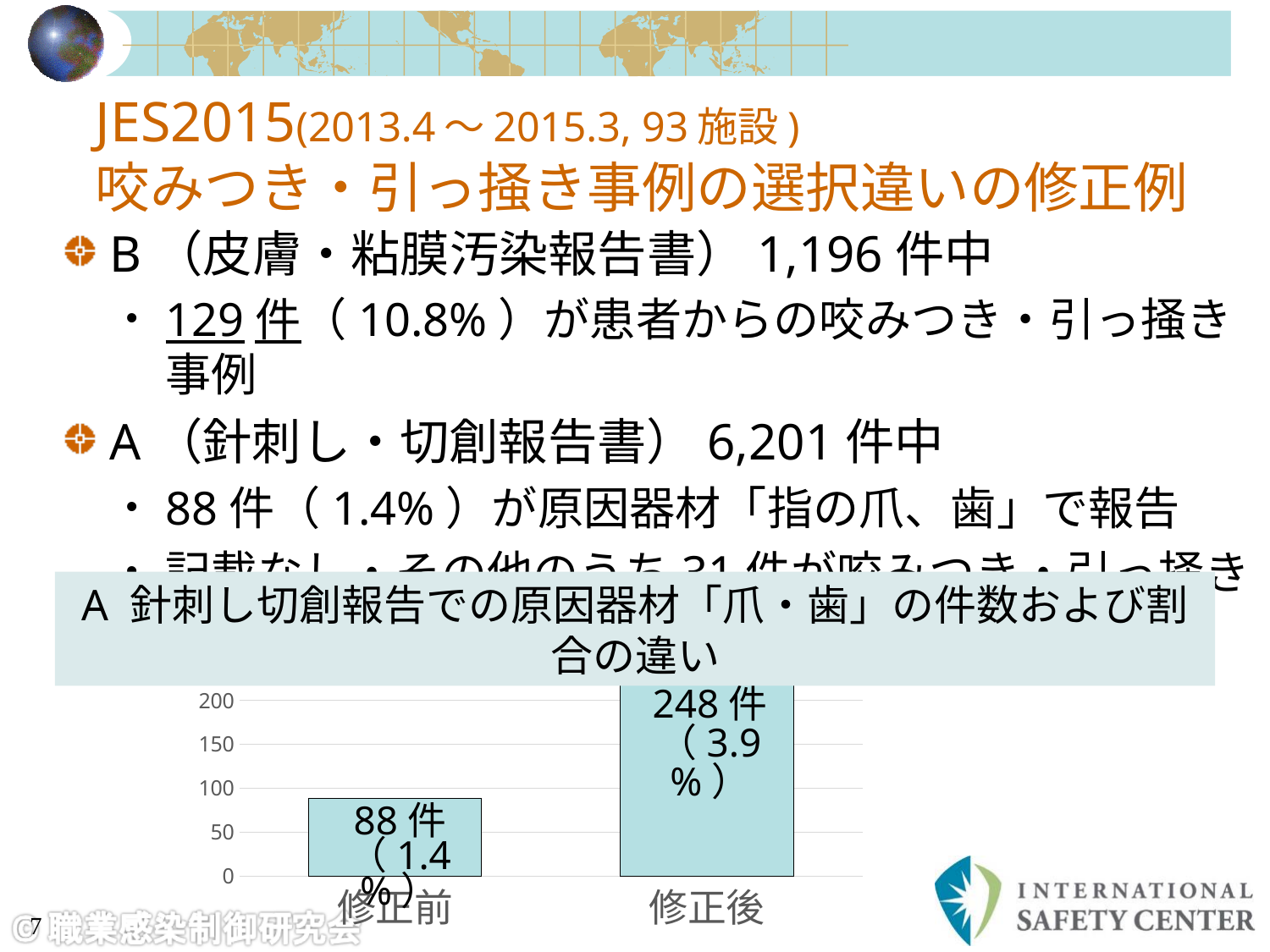
Which category has the lower value in the chart? 修正前 What is the difference in the number of cases between 修正後 and 修正前? 160 件 Which category has the higher value, 修正前 or 修正後? 修正後 What percentage is shown for 修正後 in the chart? 3.9% Is the value for 修正後 greater or less than 200? greater What is the value for 修正前 in the chart? 88 件（1.4%） Is the value for 修正前 greater or less than 100? less How many categories are shown on the x axis of the chart? 2 What is the value for 修正後 in the chart? 248 件（3.9%） Do the values rise or fall from 修正前 to 修正後? rise What kind of chart is shown on the slide? bar chart What is the title of the chart? A 針刺し切創報告での原因器材「爪・歯」の件数および割合の違い